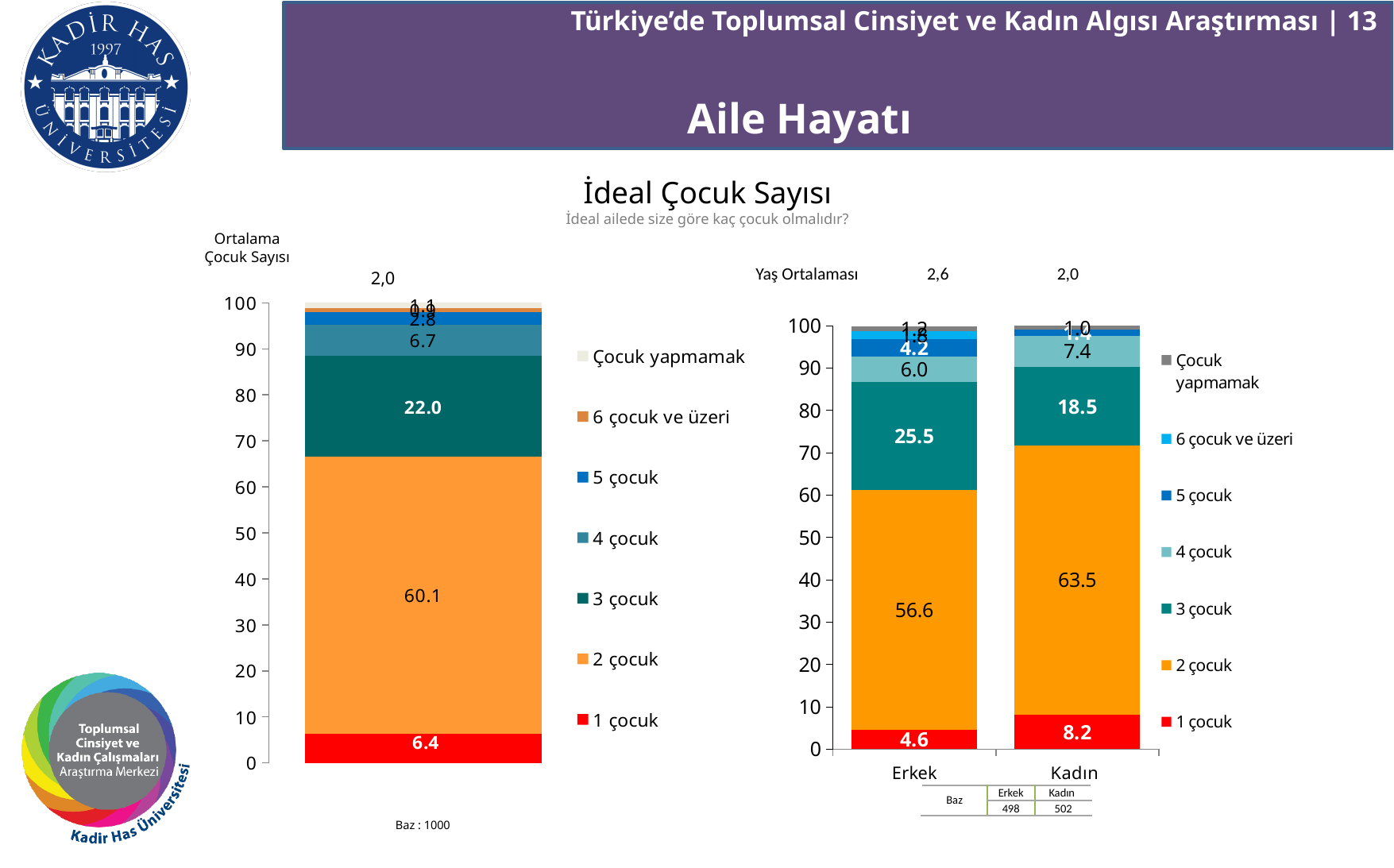
In the right chart (Erkek / Kadın), which bar has the larger '3 çocuk' value, Erkek or Kadın? Erkek How many series does the legend of the right chart (Erkek / Kadın) list? 7 In the left chart (overall), what is the value for '2 çocuk'? 60.1 In the left chart (overall), which category has the largest share of the bar? 2 çocuk In the right chart (Erkek / Kadın), what is the value for '2 çocuk' in the Kadın bar? 63.5 What is the title of the chart section on the slide? İdeal Çocuk Sayısı What type of chart is the right chart (Erkek / Kadın)? Stacked bar chart In the left chart (overall), what is the value for '1 çocuk'? 6.4 In the right chart (Erkek / Kadın), what is the value for '1 çocuk' in the Kadın bar? 8.2 In the right chart (Erkek / Kadın), what is the difference between the '2 çocuk' values for Kadın and Erkek? 6.9 In the left chart (overall), what is the value for '3 çocuk'? 22.0 In the right chart (Erkek / Kadın), what is the value for '3 çocuk' in the Erkek bar? 25.5